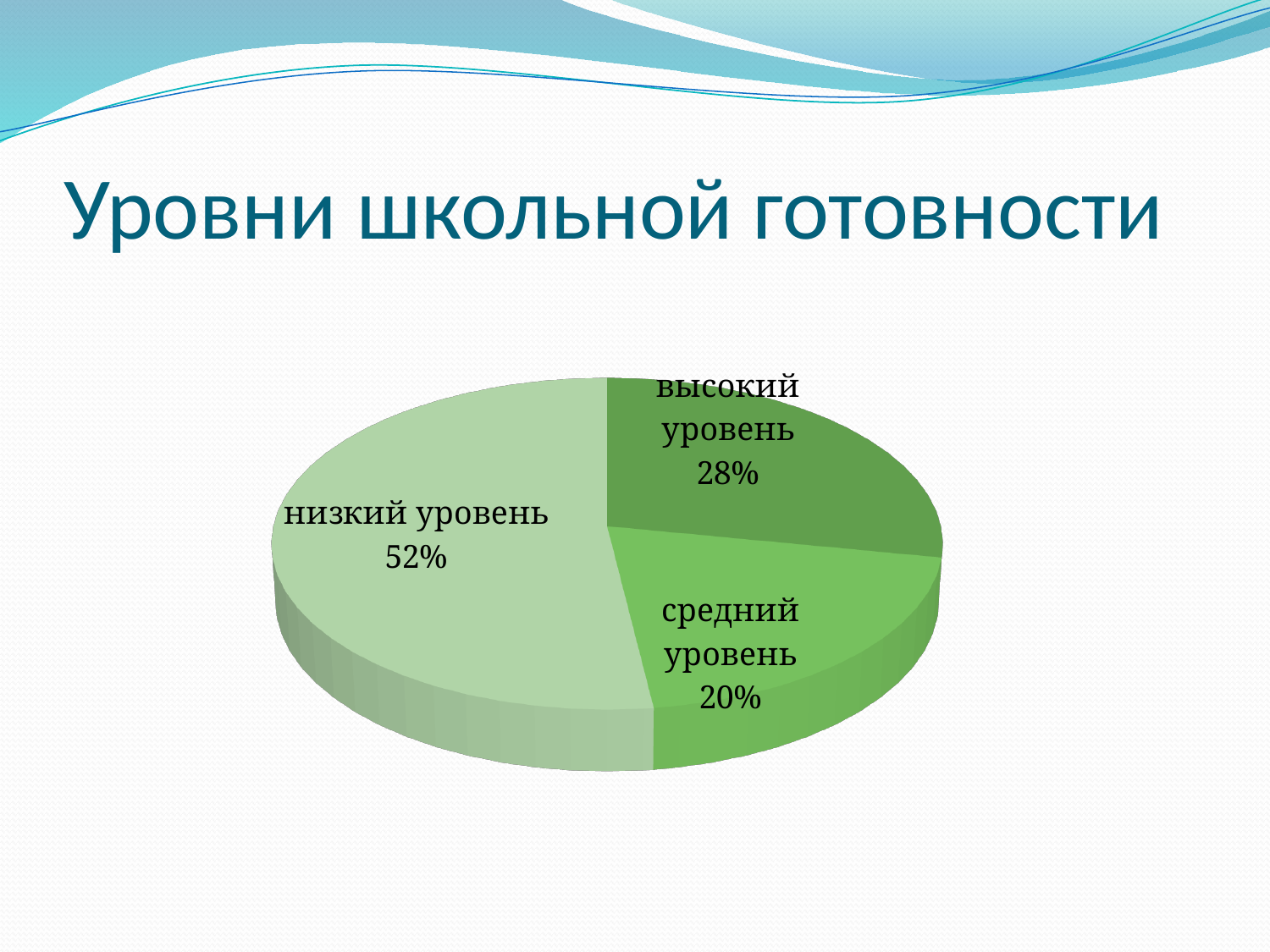
What share of the pie does "высокий уровень" represent? 28% What is the difference between the shares of "высокий уровень" and "средний уровень"? 8% What is the title of the slide containing the chart? Уровни школьной готовности Which category has the smallest slice of the pie? средний уровень What share of the pie does "низкий уровень" represent? 52% What kind of chart is shown on the slide? pie chart Which is larger: the share for "высокий уровень" or for "средний уровень"? высокий уровень How many categories are shown in the pie chart? 3 What is the value shown for "средний уровень"? 20% Which category has the largest slice of the pie? низкий уровень What is the difference between the shares of "низкий уровень" and "высокий уровень"? 24% Which category is shown in the lightest green slice? низкий уровень